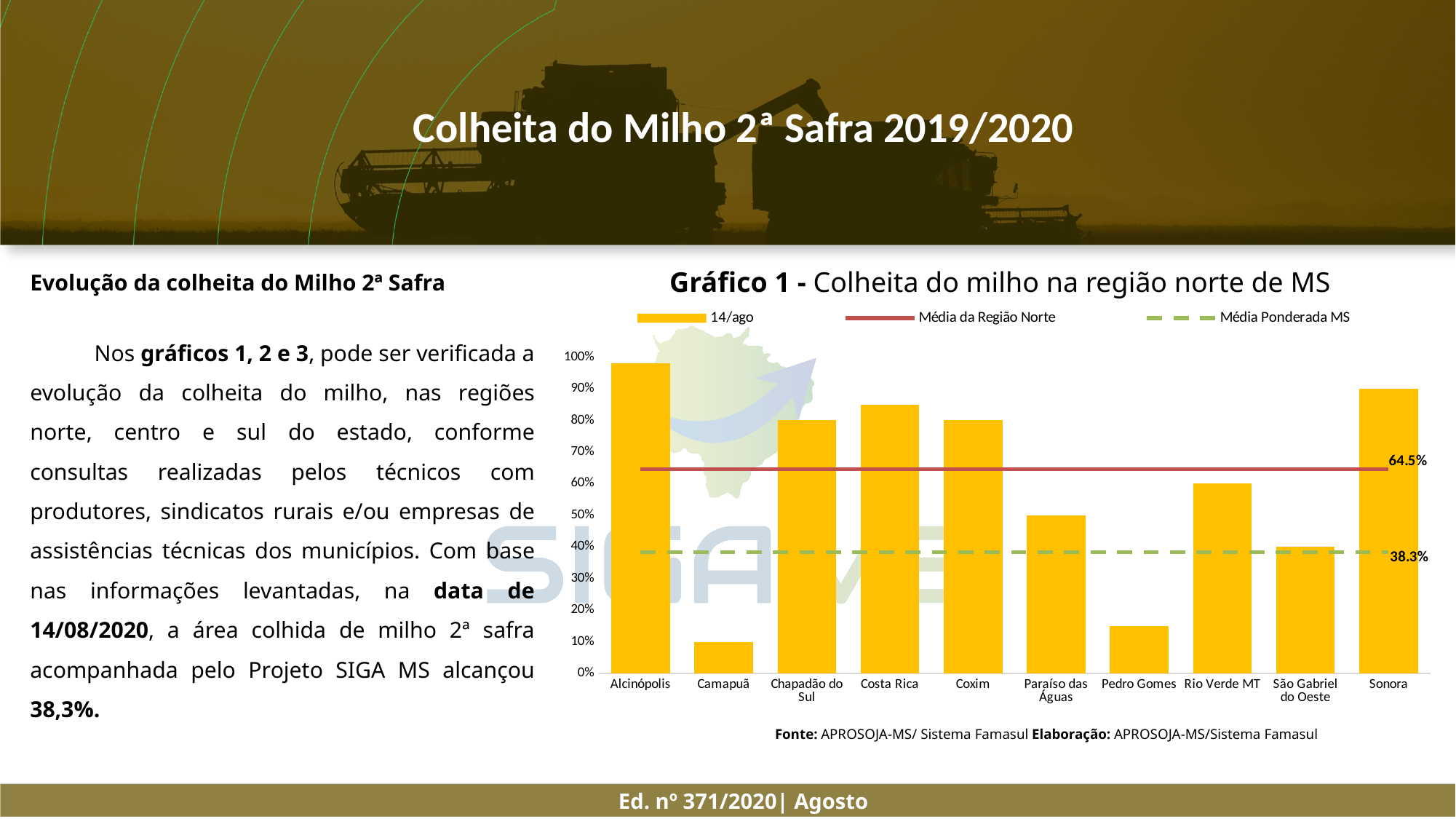
Which municipality has the highest bar in Gráfico 1? Alcinópolis In Gráfico 1, is the value for Pedro Gomes greater or less than 20%? less How many municipalities are shown on the x axis of Gráfico 1? 10 In Gráfico 1, what is the difference between the Média da Região Norte (64.5%) and the Média Ponderada MS (38.3%)? 26.2 percentage points Which municipality has the lowest bar in Gráfico 1? Camapuã How many entries does the legend of Gráfico 1 list? 3 In Gráfico 1, which is larger, the bar for Sonora or the bar for Costa Rica? Sonora In Gráfico 1, is the value for Sonora greater or less than 80%? greater What date does the bar series in the legend of Gráfico 1 refer to? 14/ago What type of chart is Gráfico 1? Bar chart What value is labelled for the Média Ponderada MS line in Gráfico 1? 38.3% What value is labelled for the Média da Região Norte line in Gráfico 1? 64.5%